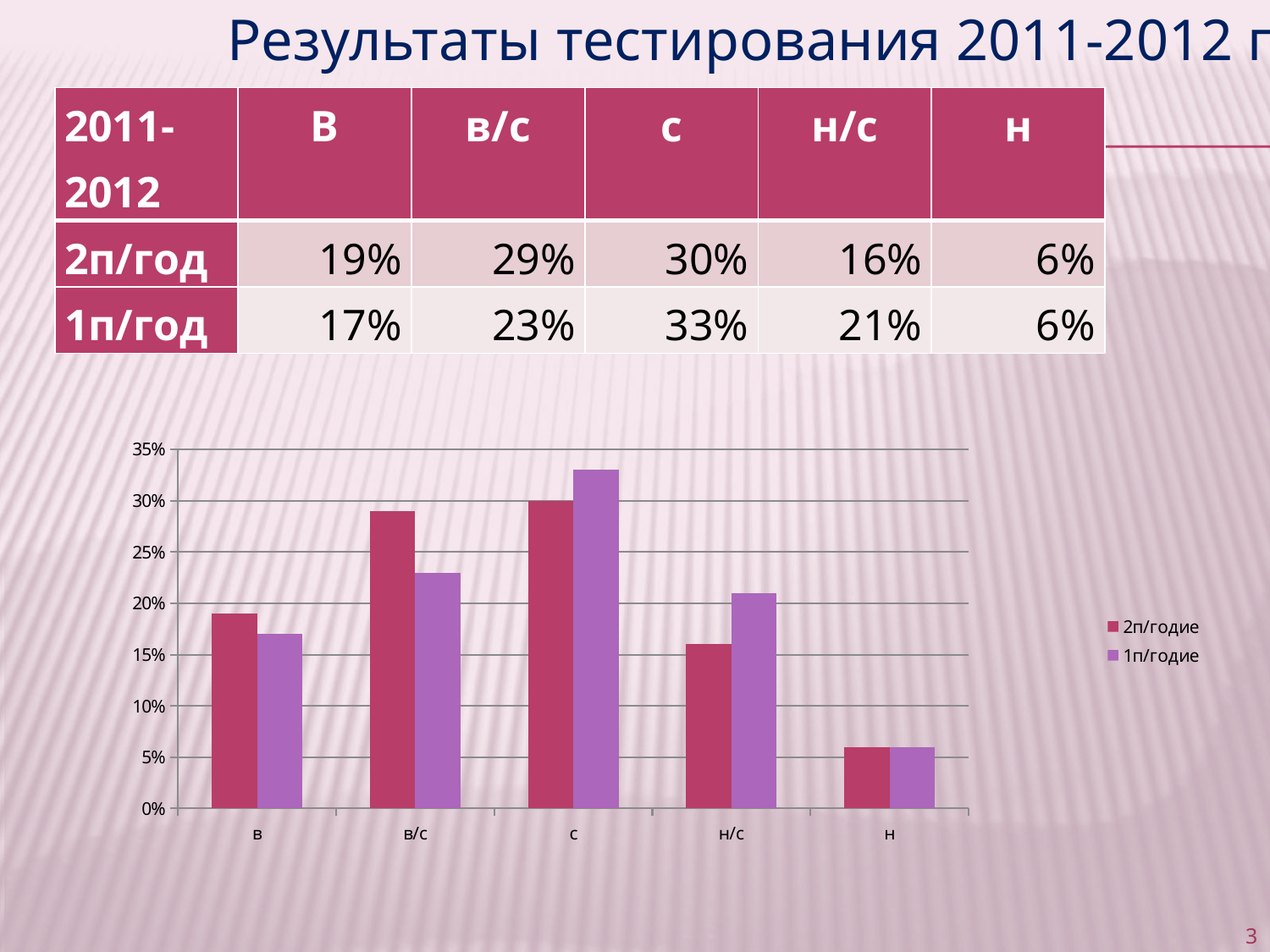
Which category has the lowest value in the 2п/годие series? н How many series does the chart legend list? 2 Which category has the highest value in the 1п/годие series? с What is the value for category н/с in the 1п/годие series? 21% What are the two entries listed in the chart legend? 2п/годие and 1п/годие Is the value for category н/с in the 2п/годие series greater or less than 20%? less What is the value for category с in the 2п/годие series? 30% What kind of chart is shown on the slide? bar chart For category в, which series has the larger value, 2п/годие or 1п/годие? 2п/годие How many categories are shown on the x axis of the chart? 5 What is the value for category в/с in the 2п/годие series? 29% What is the difference between the 1п/годие and 2п/годие values for category в/с? 6%